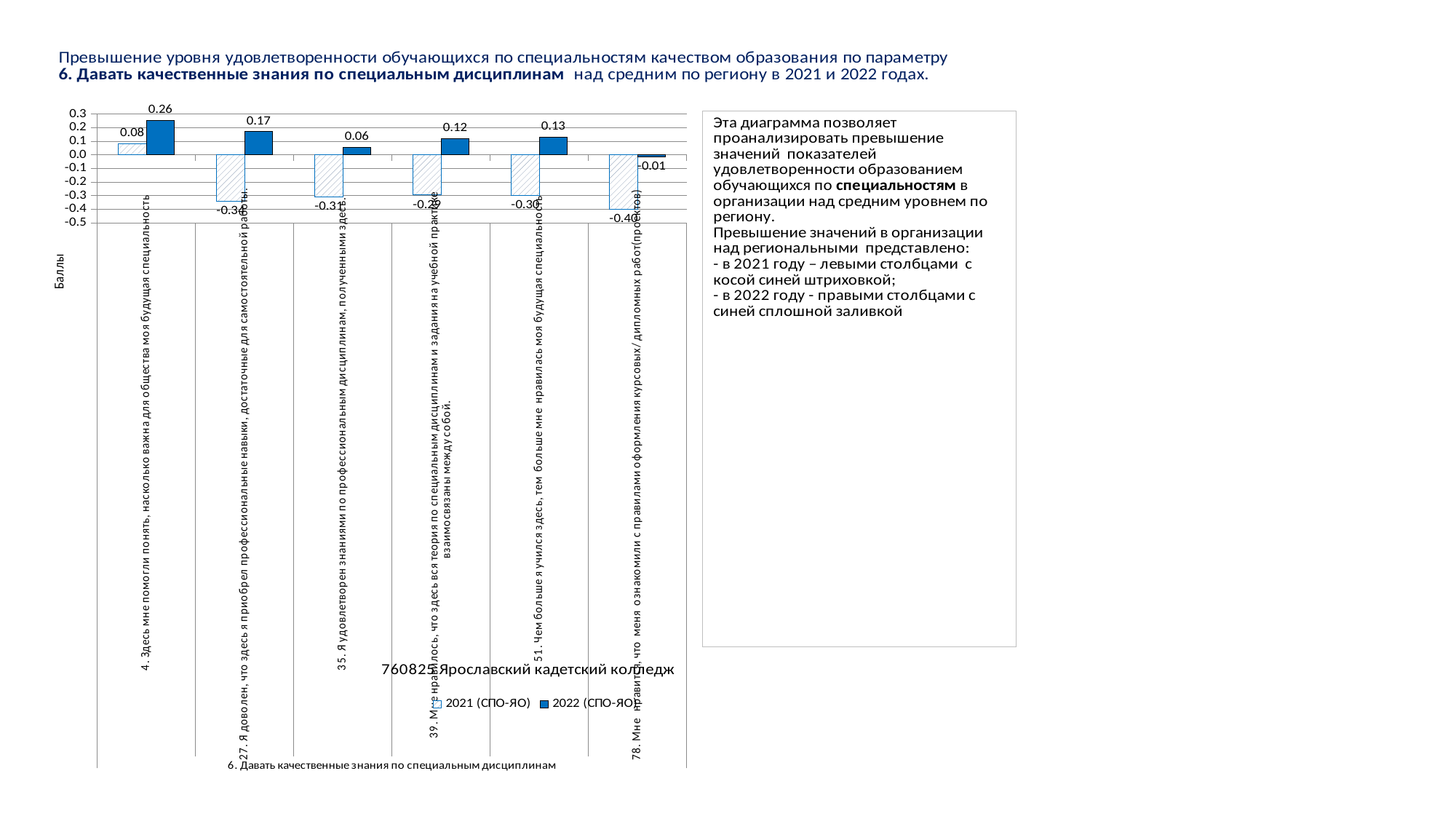
What is the 2021 (СПО-ЯО) value for category 4 ("Здесь мне помогли понять...")? 0.08 What is the 2021 (СПО-ЯО) value for category 78 ("Мне нравится, что меня ознакомили с правилами оформления курсовых...")? -0.40 What is the difference between the 2022 and 2021 values for category 4? 0.18 What is the 2022 (СПО-ЯО) value for category 4 ("Здесь мне помогли понять, насколько важна для общества моя будущая специальность")? 0.26 Which category has the highest 2022 (СПО-ЯО) value? 4. Здесь мне помогли понять, насколько важна для общества моя будущая специальность What is the 2021 (СПО-ЯО) value for category 51 ("Чем больше я учился здесь, тем больше мне нравилась моя будущая специальность")? -0.30 Which is larger: the 2022 value for category 27 or the 2022 value for category 51? Category 27 (0.17) How many categories are plotted on the chart? 6 How many series does the legend list? 2 What is the 2022 (СПО-ЯО) value for category 78 ("Мне нравится, что меня ознакомили с правилами оформления курсовых...")? -0.01 What is the 2022 (СПО-ЯО) value for category 27 ("Я доволен, что здесь я приобрел профессиональные навыки...")? 0.17 Which category has the lowest 2022 (СПО-ЯО) value? 78. Мне нравится, что меня ознакомили с правилами оформления курсовых/дипломных работ(проектов)